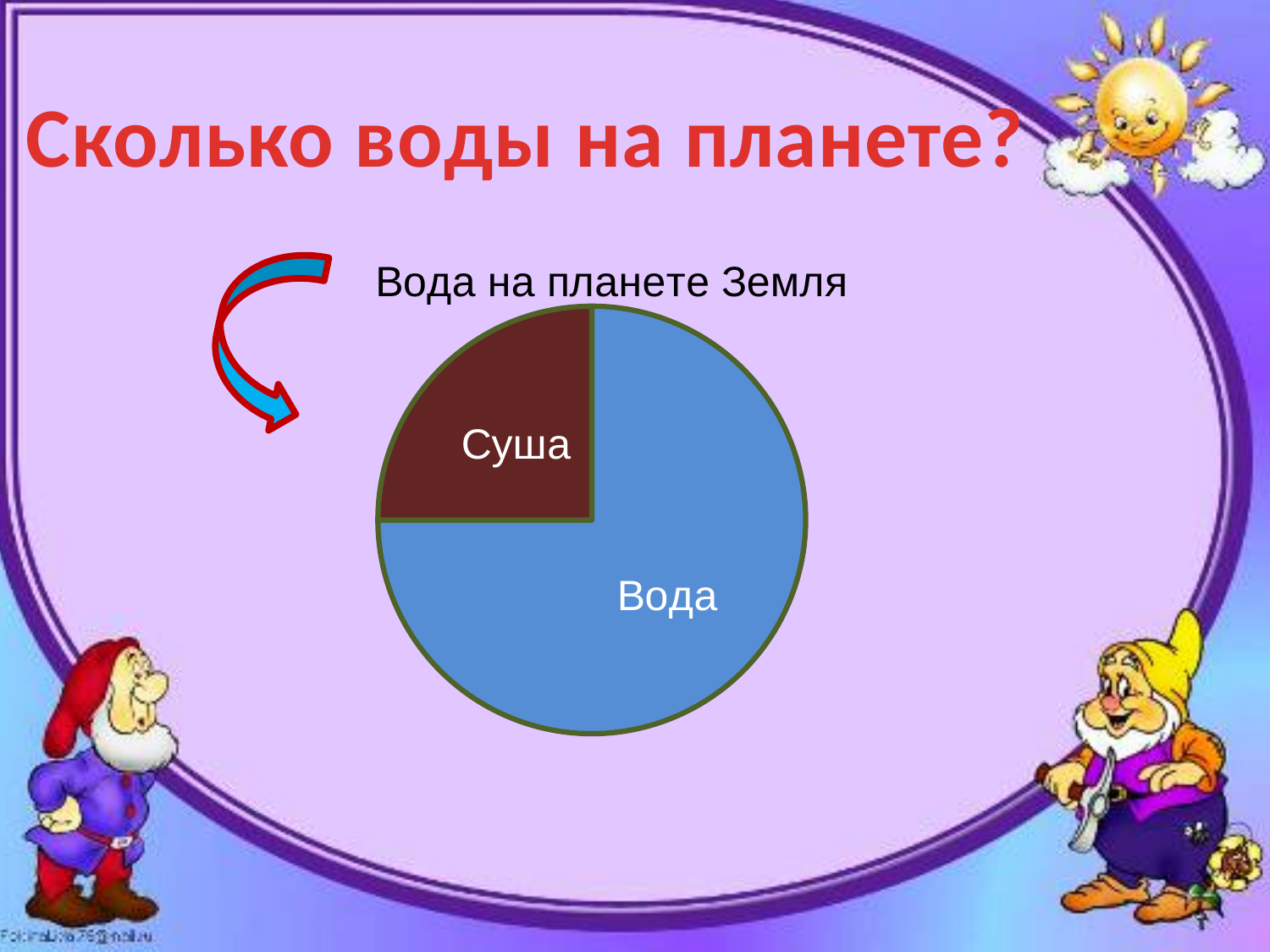
What kind of chart is shown on the slide? pie chart What are the labels of the two slices in the pie chart? Суша and Вода What colour is the Суша slice of the pie chart? dark red Which slice of the pie chart is the largest? Вода What is the title of the chart? Вода на планете Земля Which slice of the pie chart is the smallest? Суша How many slices does the pie chart have? 2 Which slice is larger, Суша or Вода? Вода